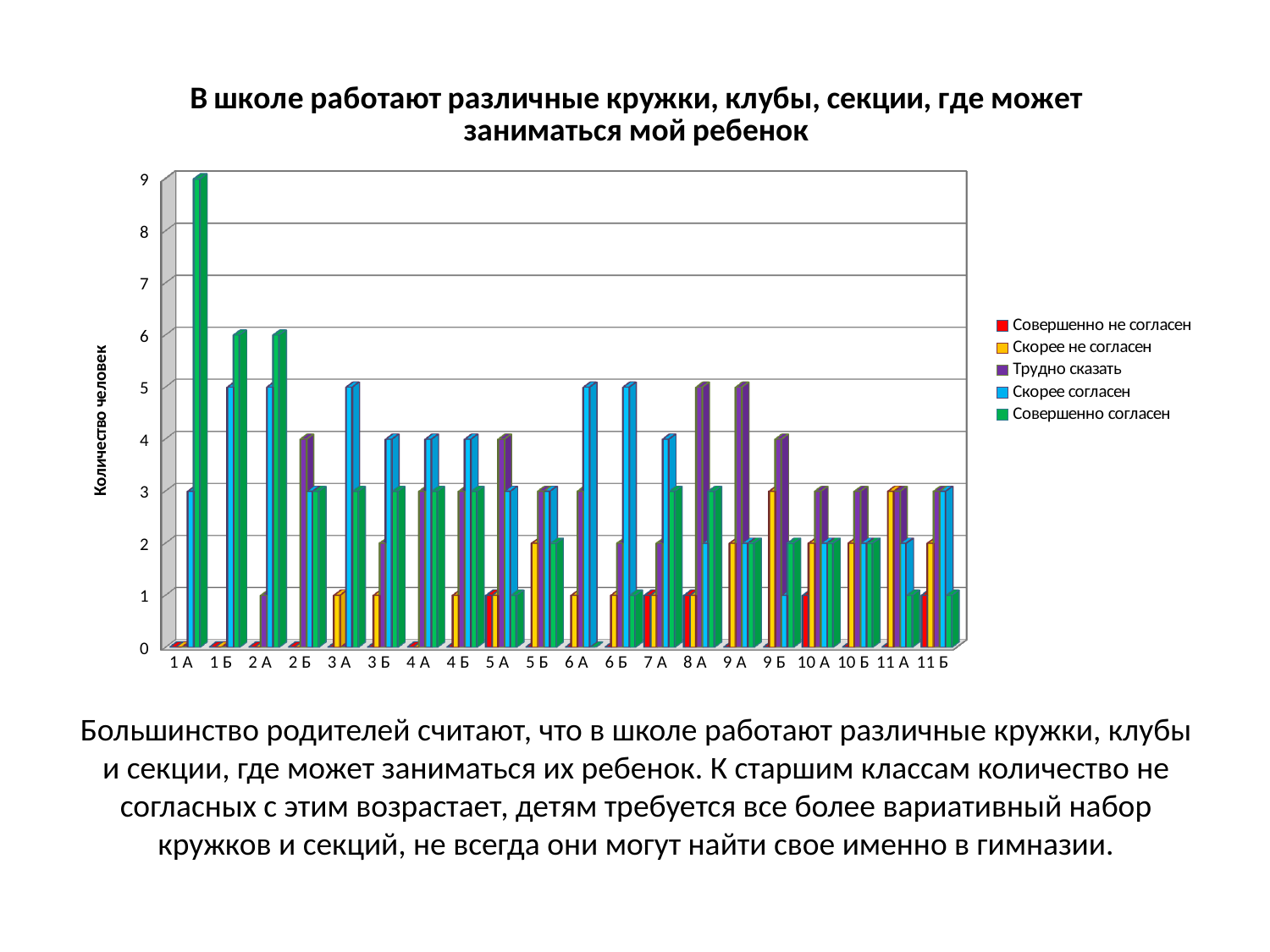
Is the value for "Совершенно согласен" in class 1 А greater or less than 8? greater Is the value for "Скорее согласен" in class 3 А greater or less than 4? greater How many series does the legend list? 5 How many class categories are shown along the x axis? 20 Is the value for "Трудно сказать" in class 9 А greater or less than 4? greater What is the value for "Совершенно согласен" in class 1 А? 9 Which is larger: the value for "Совершенно согласен" in class 1 А or in class 1 Б? 1 А Which is larger: the value for "Скорее согласен" in class 1 Б or in class 11 А? 1 Б What kind of chart is shown on the slide? bar chart What is the label of the vertical axis of the chart? Количество человек Which class has the highest value for the series "Совершенно согласен"? 1 А